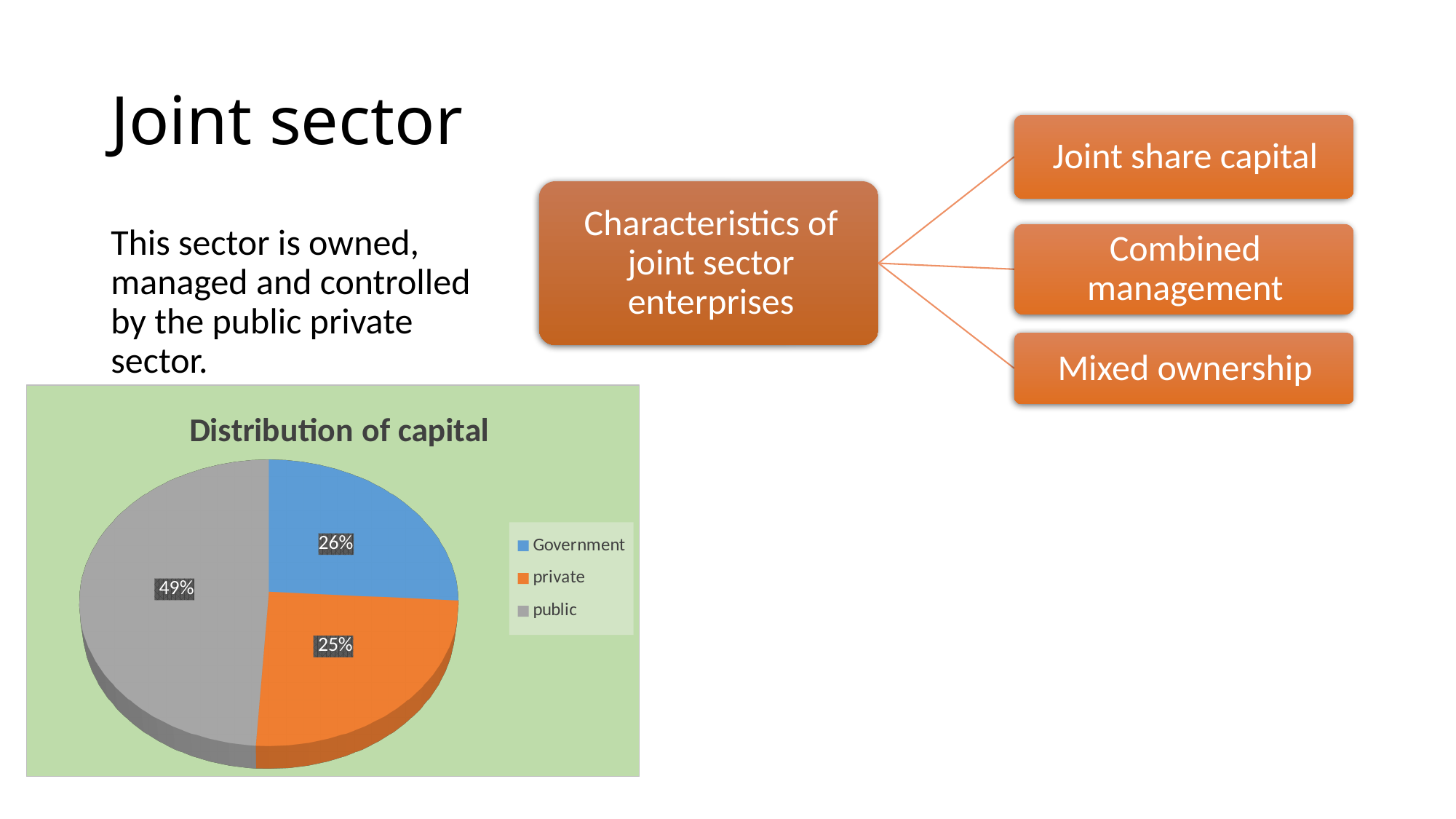
What is the difference between the public share and the Government share? 23% What share of capital does the private slice represent? 25% Which category has the largest share of capital? public What type of chart is shown on the slide? Pie chart What share of capital does the public slice represent? 49% How many entries does the legend list? 3 What is the difference between the Government share and the private share? 1% What share of capital does the Government slice represent? 26% What is the title of the chart? Distribution of capital How many categories does the pie chart show? 3 Which category has the smallest share of capital? private Which colour represents the public category in the pie chart? Grey